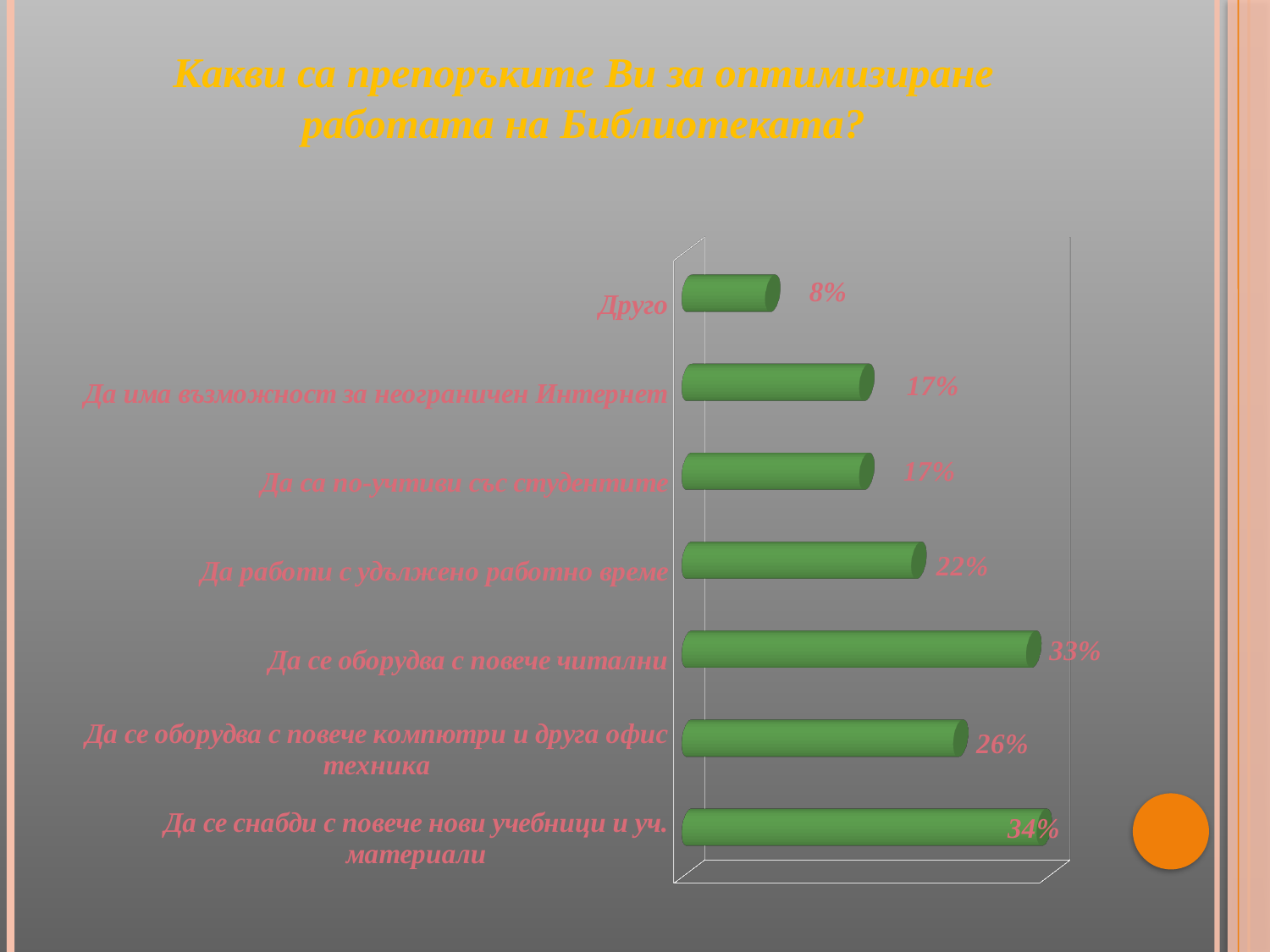
What is the value for "Да работи с удължено работно време"? 22% What is the title of the slide? Какви са препоръките Ви за оптимизиране работата на Библиотеката? How many categories are shown in the chart? 7 Which category has the highest value? Да се снабди с повече нови учебници и уч. материали Which category has the lowest value? Друго What kind of chart is shown on the slide? bar chart What is the value for "Да има възможност за неограничен Интернет"? 17% Which is larger: the value for "Да работи с удължено работно време" or the value for "Да са по-учтиви със студентите"? Да работи с удължено работно време What is the value for "Друго"? 8% What is the value for "Да се оборудва с повече читални"? 33% What is the difference between the values for "Да се оборудва с повече читални" and "Да се оборудва с повече компютри и друга офис техника"? 7% What is the value for "Да се оборудва с повече компютри и друга офис техника"? 26%